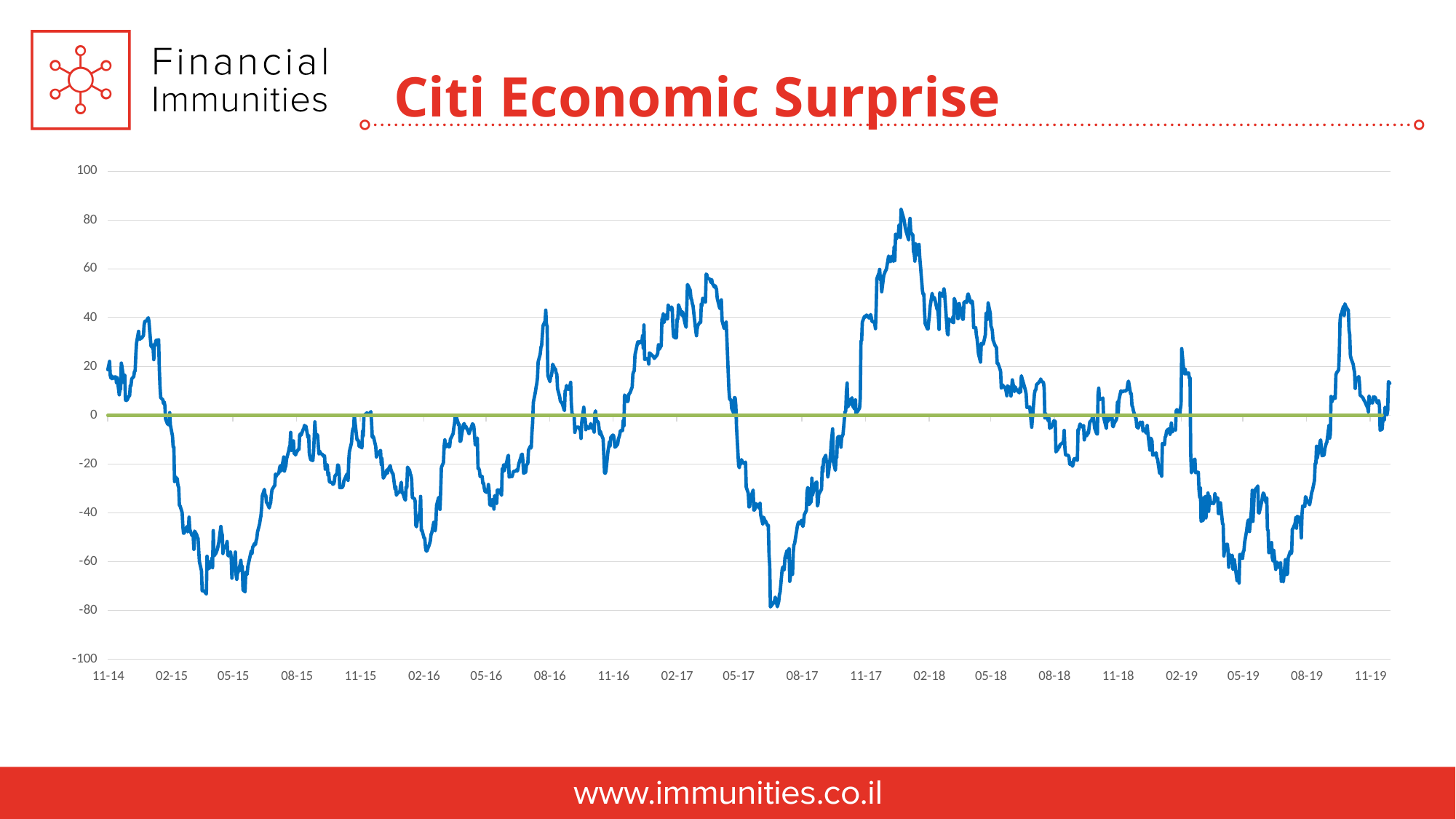
Is the lowest point of the line greater or less than -60? less At what value is the horizontal green line drawn? 0 Is the value at 05-15 greater or less than -40? less Does the line rise or fall between 11-14 and 05-15? fall Is the value at 11-14 greater or less than 0? greater What kind of chart is shown on the slide? line chart Which is larger, the value at 02-17 or the value at 05-15? 02-17 What is the title of the chart? Citi Economic Surprise